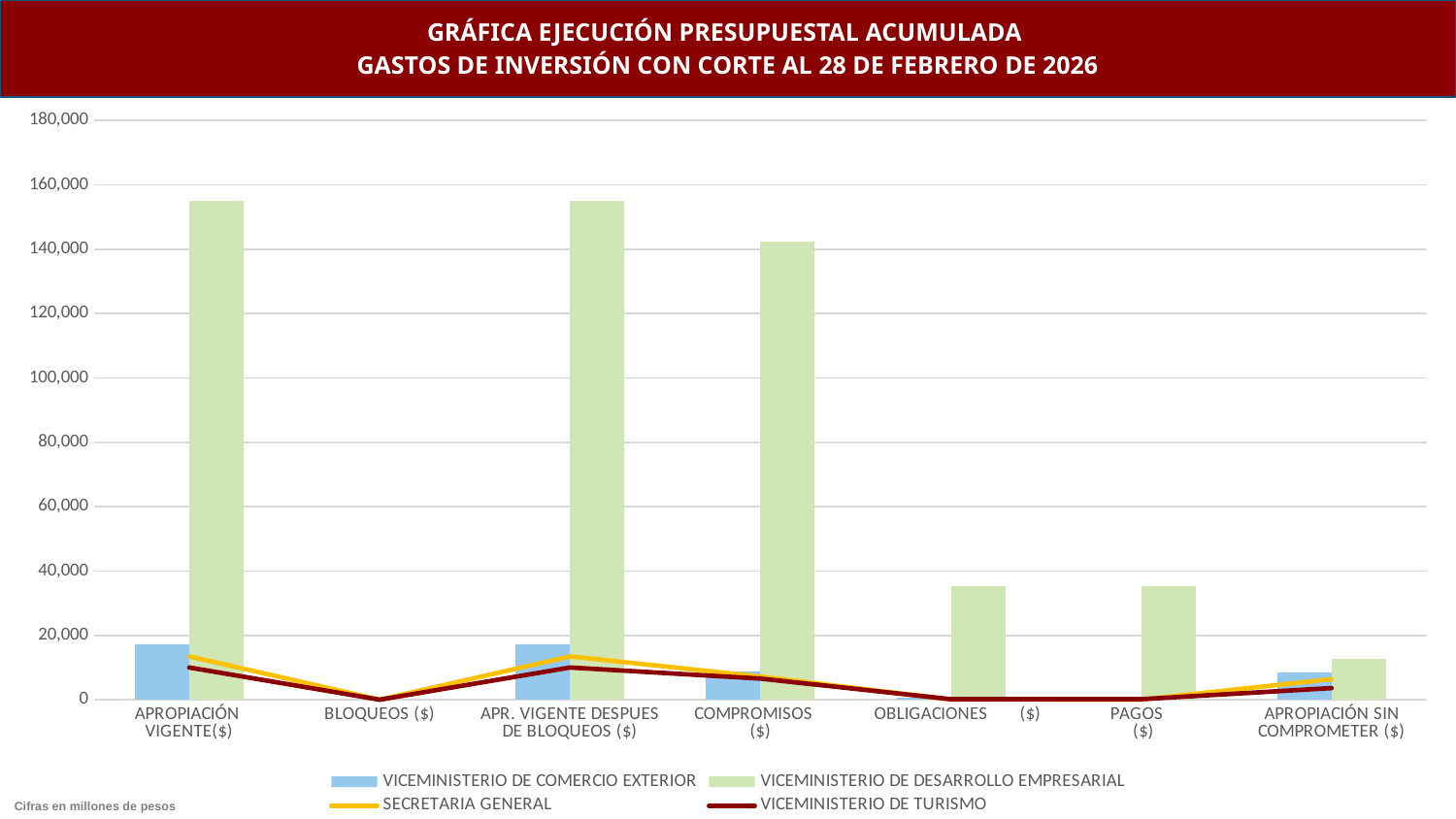
For VICEMINISTERIO DE DESARROLLO EMPRESARIAL, which is larger: the value at OBLIGACIONES ($) or at APROPIACIÓN SIN COMPROMETER ($)? OBLIGACIONES ($) Is the value for VICEMINISTERIO DE DESARROLLO EMPRESARIAL at OBLIGACIONES ($) greater or less than 40,000? less According to the note at the bottom left, in what units are the figures expressed? Millones de pesos Is the value for VICEMINISTERIO DE DESARROLLO EMPRESARIAL at APROPIACIÓN VIGENTE($) greater or less than 140,000? greater Do the values for VICEMINISTERIO DE DESARROLLO EMPRESARIAL rise or fall from COMPROMISOS ($) to PAGOS ($)? fall Is the value for VICEMINISTERIO DE DESARROLLO EMPRESARIAL at COMPROMISOS ($) greater or less than 120,000? greater How many categories are shown along the x axis? 7 How many series does the legend list? 4 At COMPROMISOS ($), which series has the larger value: VICEMINISTERIO DE DESARROLLO EMPRESARIAL or VICEMINISTERIO DE COMERCIO EXTERIOR? VICEMINISTERIO DE DESARROLLO EMPRESARIAL For VICEMINISTERIO DE DESARROLLO EMPRESARIAL, which category has the lowest value? BLOQUEOS ($) What kind of chart is shown on the slide? A combined bar and line chart